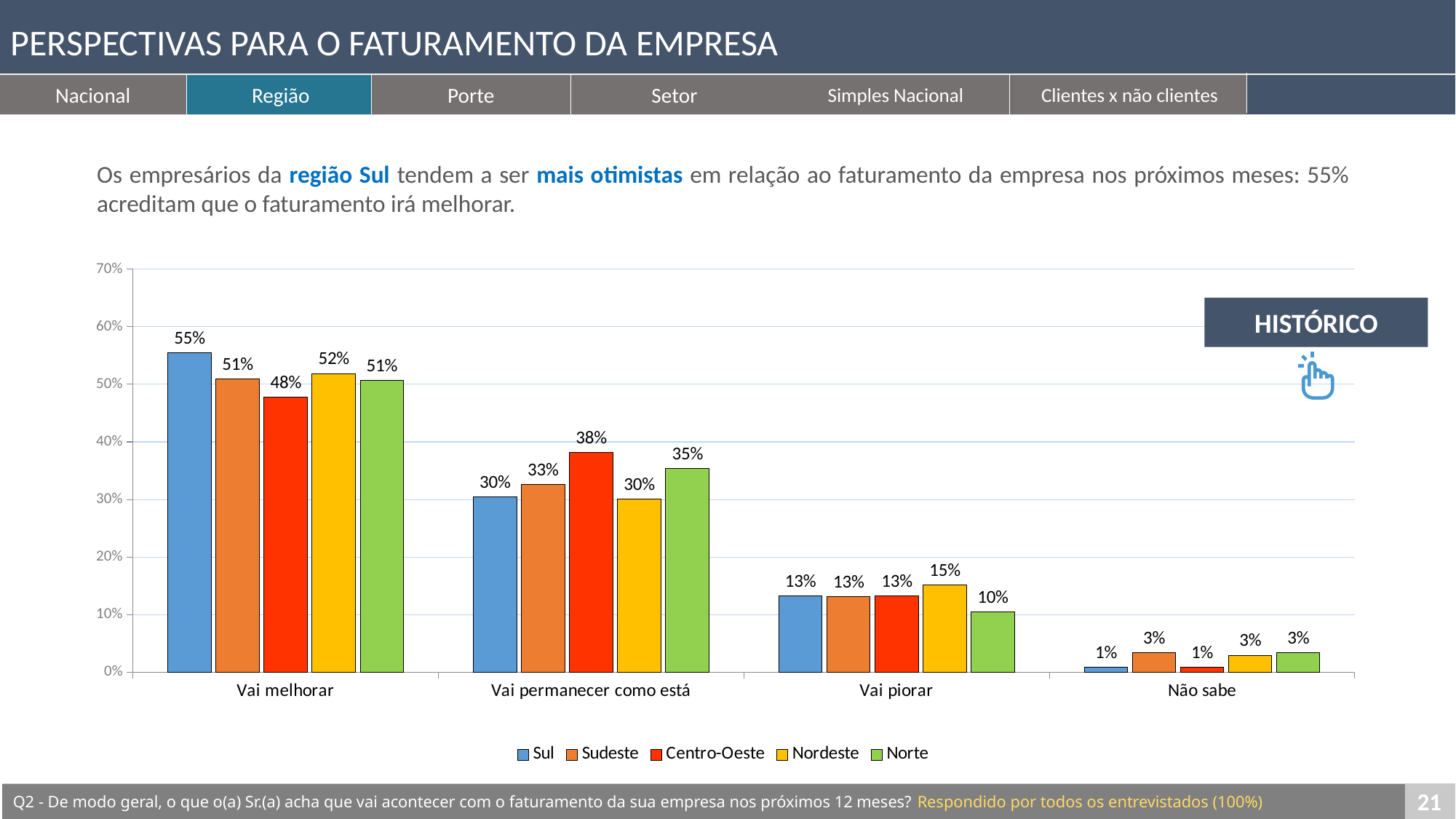
Is the value for Nordeste in the 'Vai piorar' category greater or less than 20%? less What is the difference between the Sul and Centro-Oeste values in the 'Vai melhorar' category? 7% Which region has the lowest value in the 'Vai melhorar' category? Centro-Oeste Which region has the highest value in the 'Vai melhorar' category? Sul Which is larger in the 'Vai permanecer como está' category: Sudeste or Norte? Norte What is the value for Sul in the 'Vai melhorar' category? 55% What kind of chart is shown on the slide? Bar chart How many categories are shown on the x axis? 4 How many series does the legend list? 5 What is the value for Centro-Oeste in the 'Vai permanecer como está' category? 38% What is the value for Norte in the 'Vai piorar' category? 10% Which region is represented by the red bars? Centro-Oeste